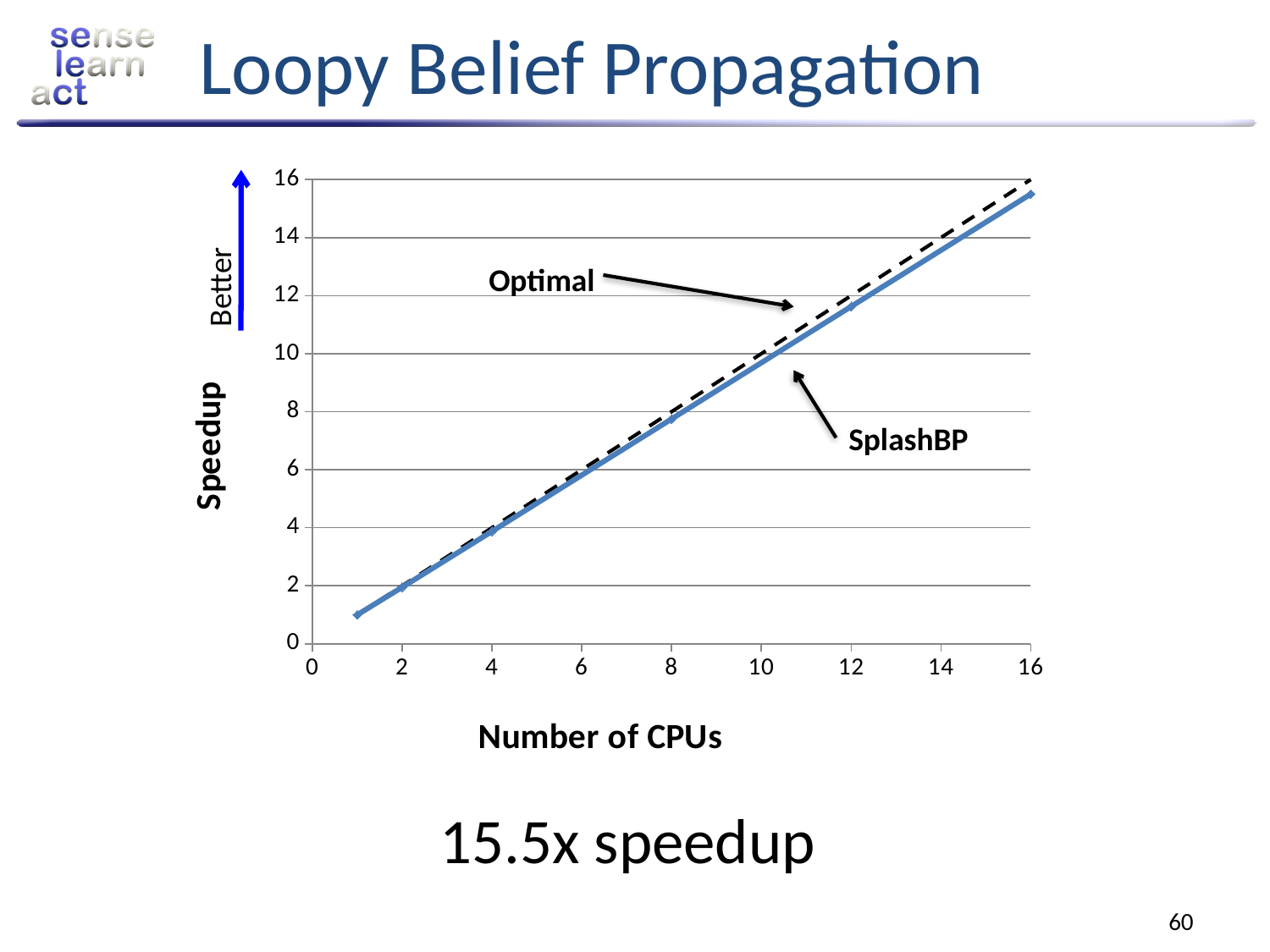
Does the SplashBP speedup rise or fall as the number of CPUs increases? rise What is the title of the y axis of the chart? Speedup What speedup does the slide report for SplashBP at 16 CPUs? 15.5x Is the SplashBP speedup at 8 CPUs greater or less than 10? less Is the SplashBP speedup at 16 CPUs greater or less than 14? greater Is the SplashBP speedup at 4 CPUs greater or less than 6? less How many lines (series) are plotted on the chart? 2 What is the highest value shown on the x axis of the chart? 16 What is the title of the x axis of the chart? Number of CPUs What kind of chart is shown on the slide? line chart